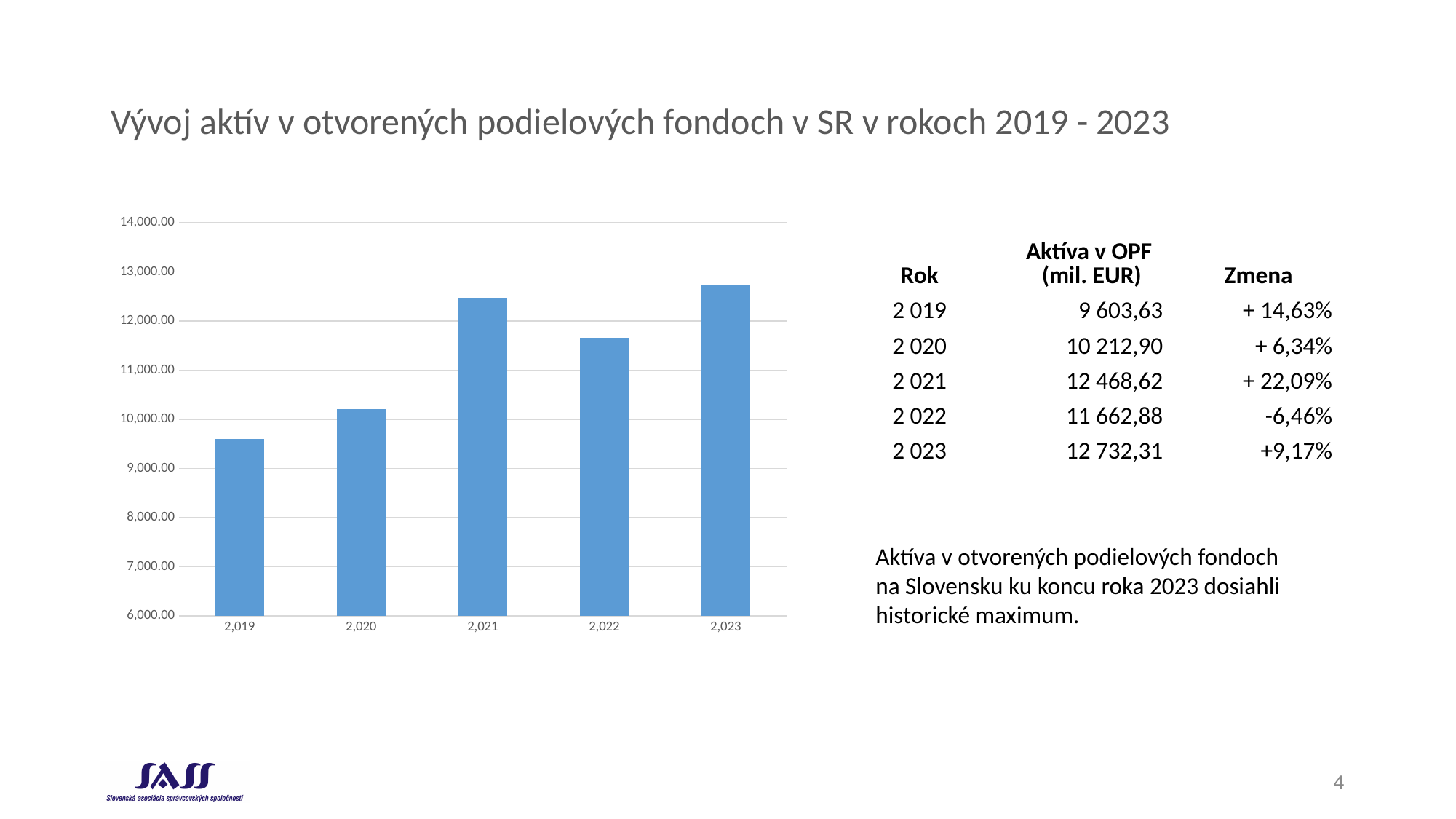
What kind of chart is shown on the slide? Bar chart What is the title of the slide above the chart? Vývoj aktív v otvorených podielových fondoch v SR v rokoch 2019 - 2023 Is the value for 2021 greater or less than 12,000.00? greater Is the value for 2022 greater or less than 12,000.00? less Is the value for 2019 greater or less than 10,000.00? less Does the value rise or fall from 2021 to 2022? Fall According to the table on the slide, what was the change (Zmena) in 2022? -6,46% Which year has the highest bar in the chart? 2023 Which year has the lowest bar in the chart? 2019 How many years (bars) does the chart show? 5 According to the table on the slide, what were the assets in OPF (mil. EUR) in 2023? 12 732,31 Which is larger, the value for 2021 or the value for 2022? 2021